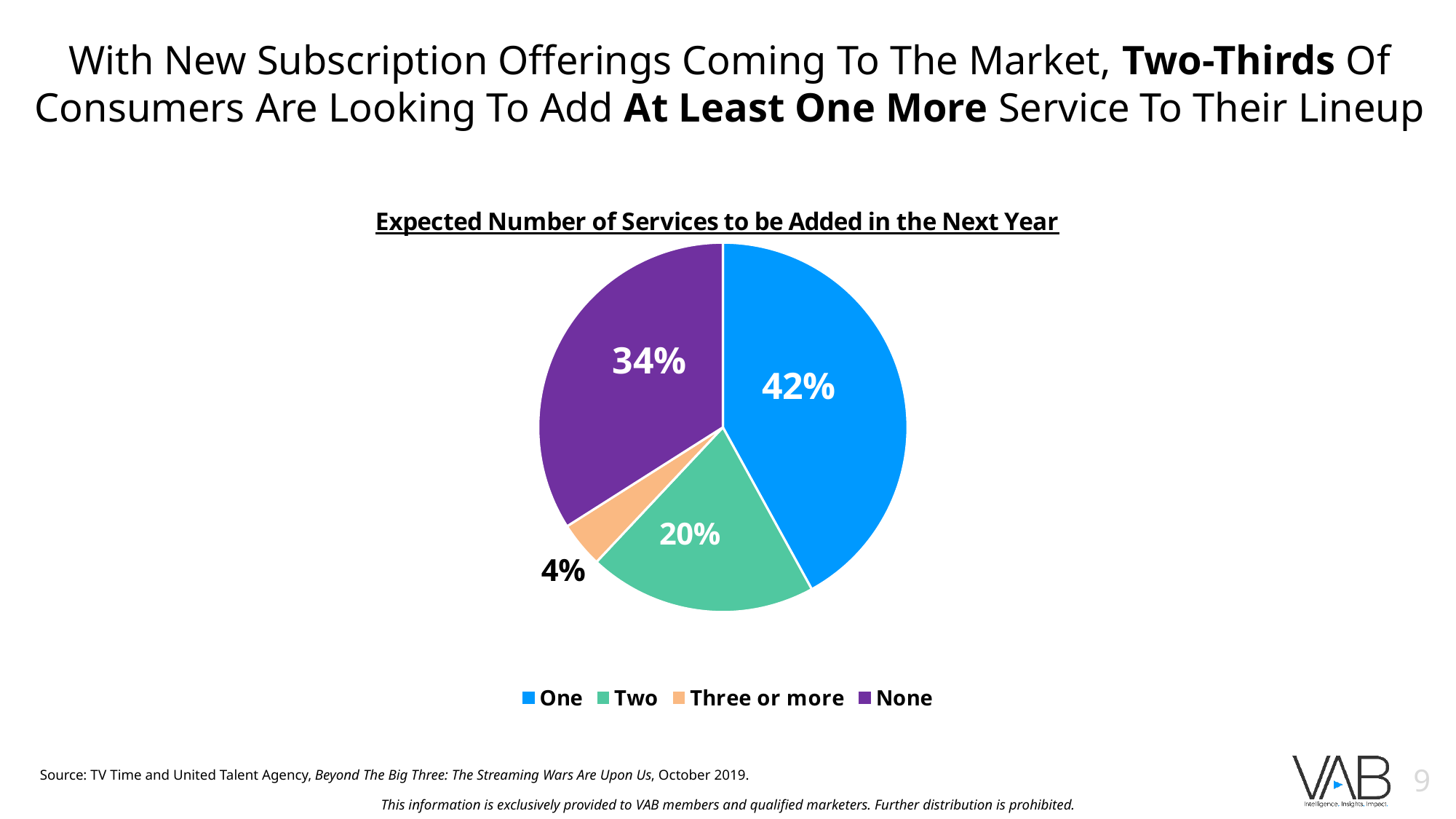
What is the title of the chart? Expected Number of Services to be Added in the Next Year Which category has the largest share of the pie? One What colour is the slice for Three or more? orange How many categories does the legend list? 4 What percentage of consumers expect to add one service in the next year? 42% What is the difference in percentage points between the One and None slices? 8 What percentage of consumers expect to add no services? 34% What type of chart is shown on the slide? pie chart What percentage of consumers expect to add two services? 20% Which is larger, the share for Two or the share for None? None Which category has the smallest share of the pie? Three or more What percentage of consumers expect to add three or more services? 4%